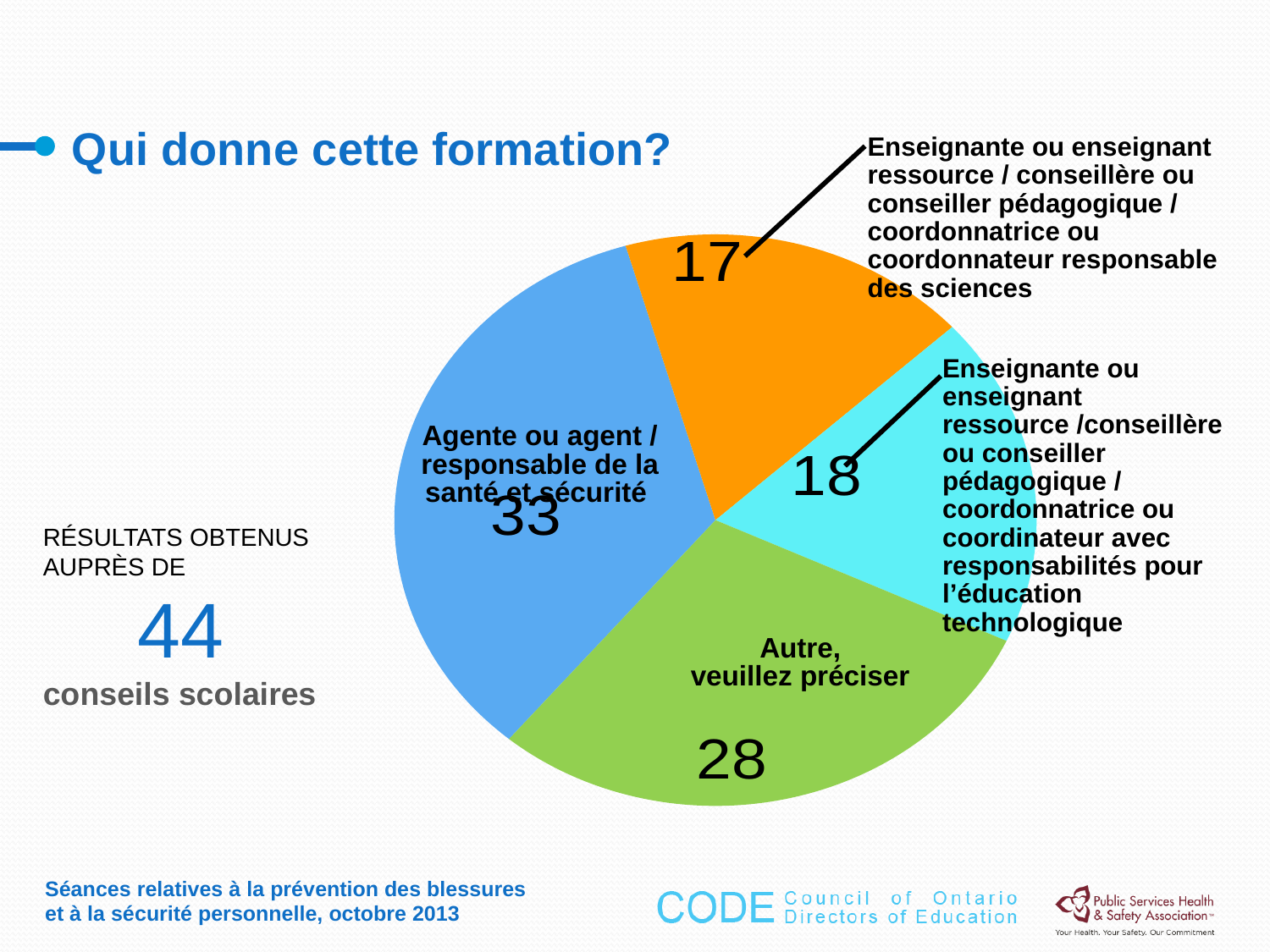
What colour is the slice labelled "Autre, veuillez préciser"? green What is the title of the slide containing the pie chart? Qui donne cette formation? Which slice of the pie chart has the highest value? Agente ou agent / responsable de la santé et sécurité What is the difference between the value for "Agente ou agent / responsable de la santé et sécurité" and the value for "Autre, veuillez préciser"? 5 Which is larger: the slice for the sciences teacher/consultant (17) or the slice for the technological education teacher/consultant (18)? the technological education slice (18) What kind of chart is shown on the slide? pie chart What is the value for the slice labelled "Agente ou agent / responsable de la santé et sécurité"? 33 What is the value for the slice for the teacher/consultant responsible for sciences ("responsable des sciences")? 17 How many slices does the pie chart have? 4 What is the value for the slice labelled "Autre, veuillez préciser"? 28 What is the value for the slice for the teacher/consultant with responsibilities for technological education ("l'éducation technologique")? 18 Which slice of the pie chart has the lowest value? Enseignante ou enseignant ressource / conseillère ou conseiller pédagogique / coordonnatrice ou coordonnateur responsable des sciences